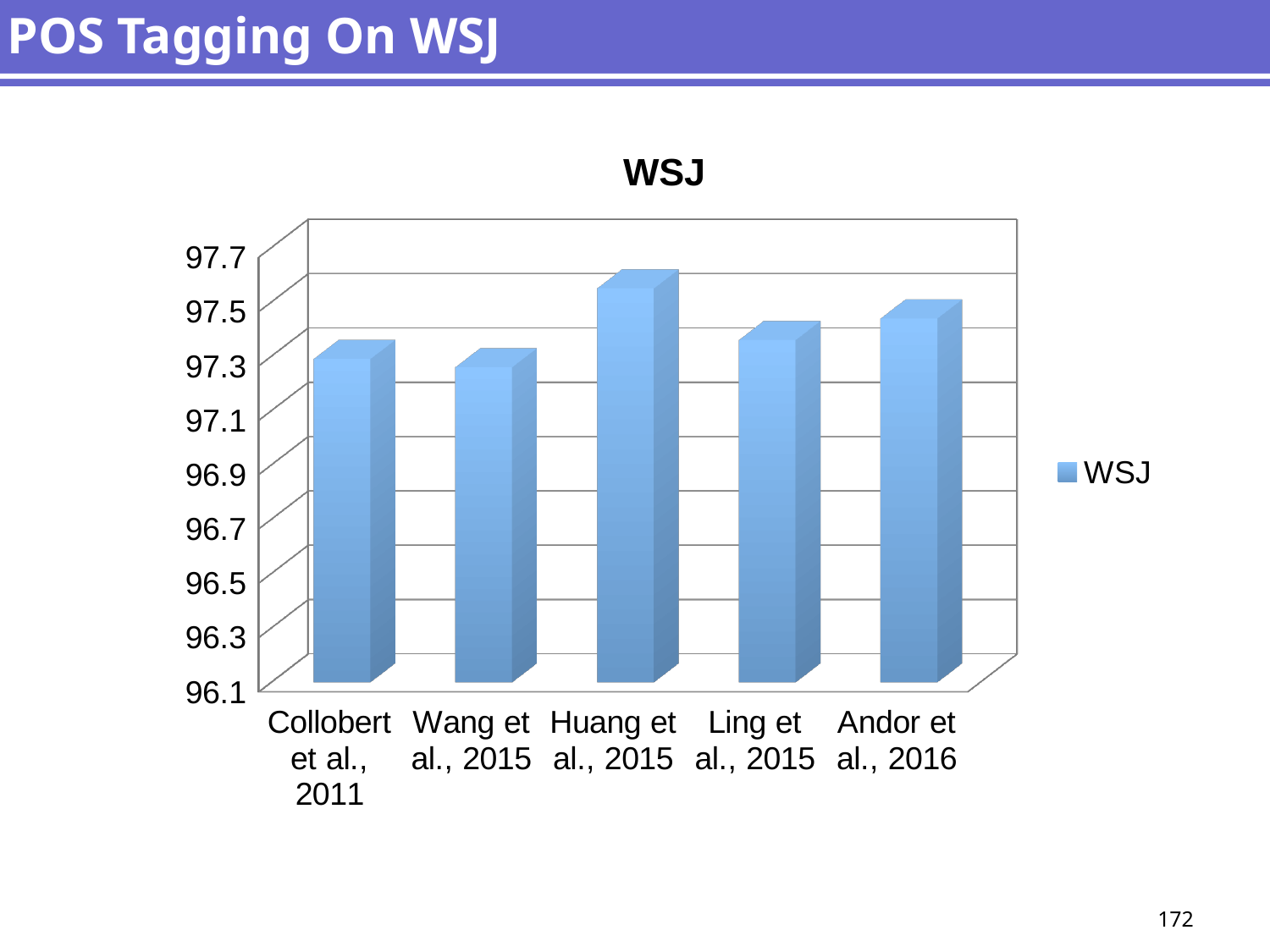
Is the value for Wang et al., 2015 greater or less than 97.5? less How many categories (papers) are plotted on the chart? 5 Which paper has the highest value on the chart? Huang et al., 2015 Which is larger, the value for Andor et al., 2016 or the value for Wang et al., 2015? Andor et al., 2016 How many series does the legend list? 1 What is the title of the chart? WSJ Is the value for Ling et al., 2015 greater or less than 97.1? greater What kind of chart is shown on the slide? bar chart Which is larger, the value for Huang et al., 2015 or the value for Andor et al., 2016? Huang et al., 2015 Which is larger, the value for Huang et al., 2015 or the value for Ling et al., 2015? Huang et al., 2015 Is the value for Huang et al., 2015 greater or less than 97.3? greater What is the name of the series shown in the legend? WSJ